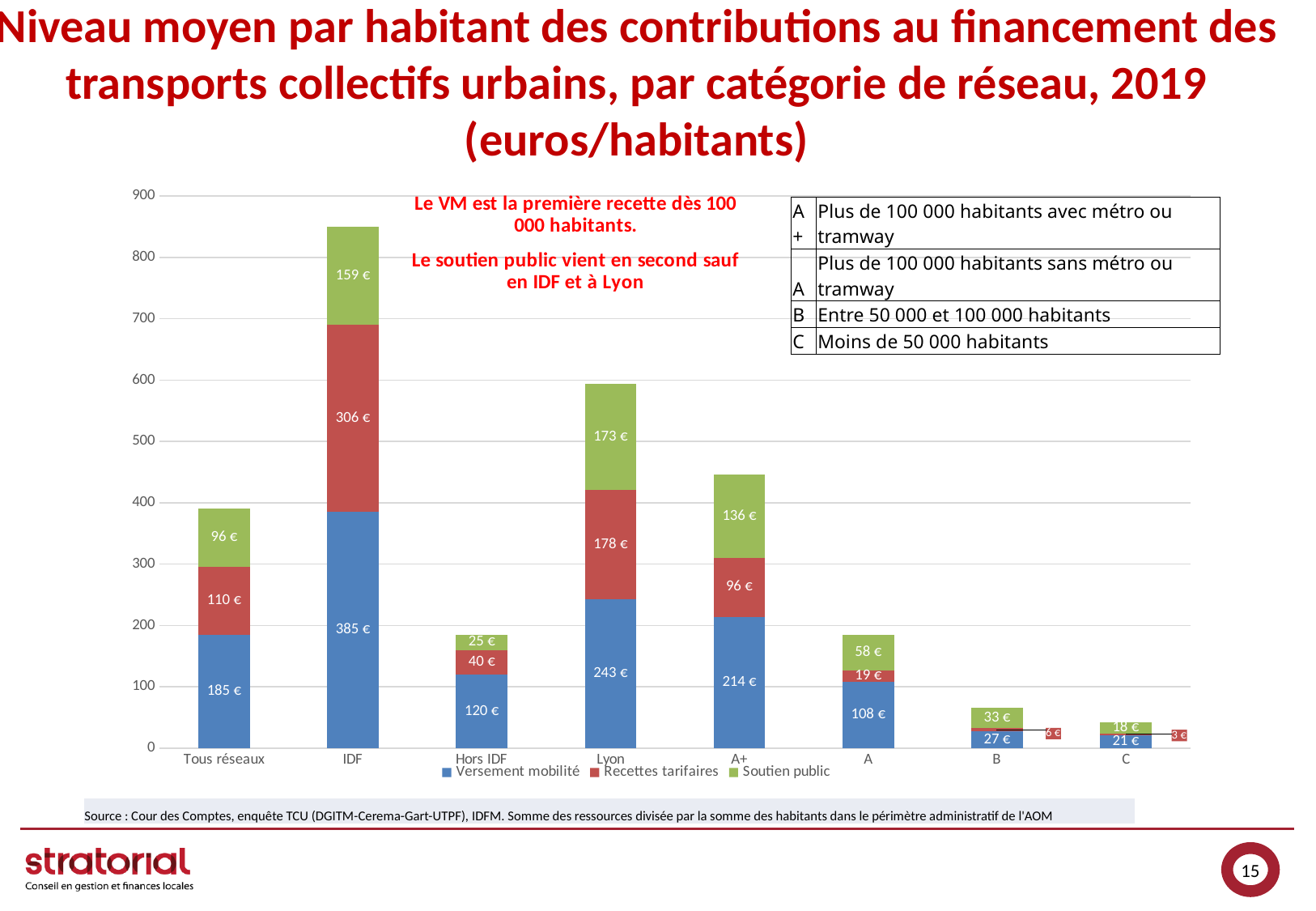
How many categories are shown on the x axis? 8 Which series is shown in green in the legend? Soutien public What is the total of the stacked bar for Tous réseaux? 391 € Which is larger, the Soutien public value for A+ or for IDF? IDF What is the value of Soutien public for Lyon? 173 € What type of chart is shown on the slide? stacked bar chart What is the value of Recettes tarifaires for A? 19 € Which category has the lowest Recettes tarifaires value? C What is the value of Versement mobilité for IDF? 385 € How many series does the legend list? 3 What is the difference between the Versement mobilité values for Lyon and A+? 29 € Which category has the highest Versement mobilité value? IDF